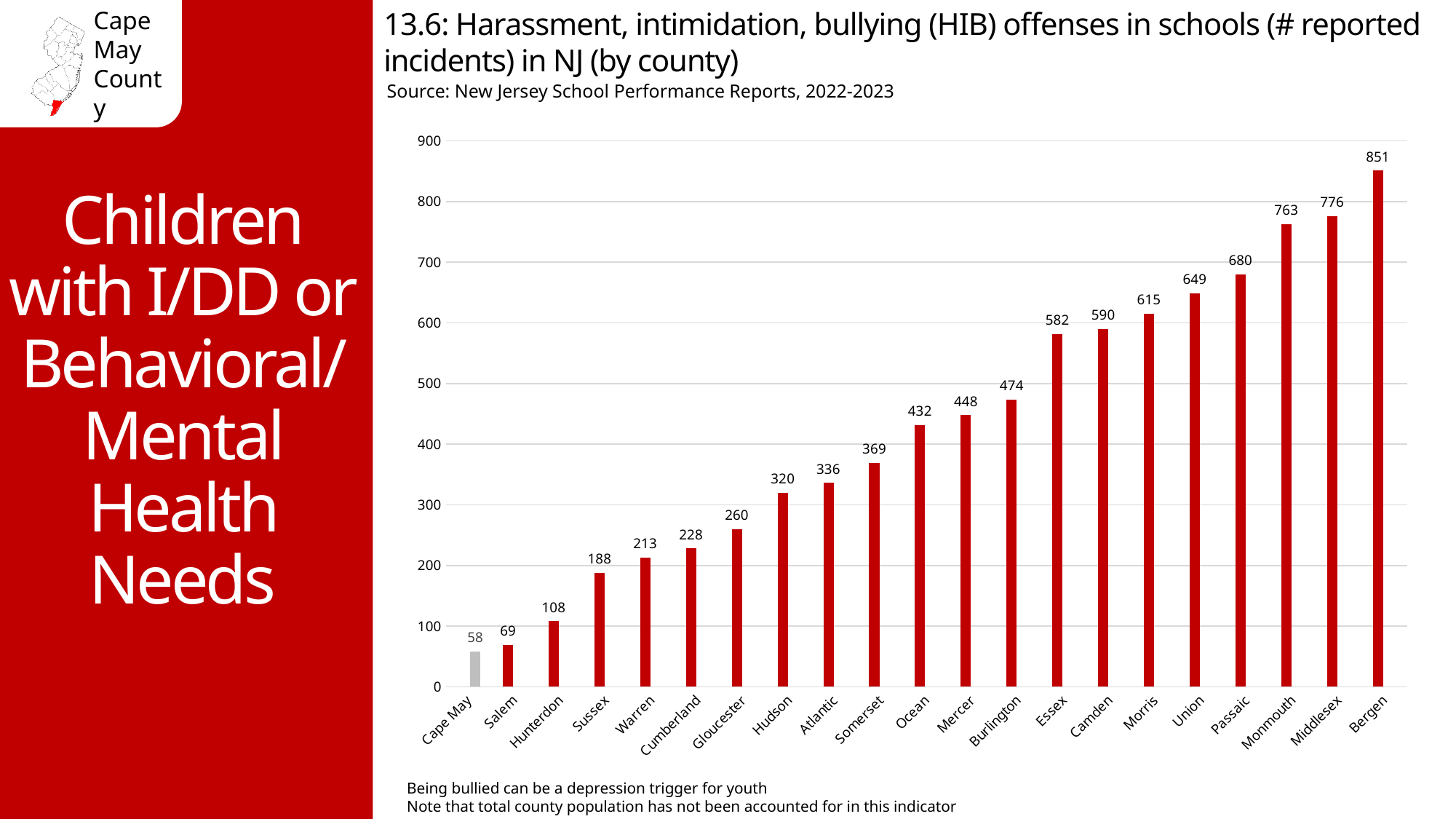
Which county has the highest number of reported HIB incidents? Bergen What is the difference between the values for Essex and Camden? 8 What is the value shown for Hudson? 320 What is the value shown for Monmouth? 763 Which county has the lowest number of reported HIB incidents? Cape May Do the values rise or fall moving from left to right along the x axis? Rise What kind of chart is shown on the slide? Bar chart Which bar is coloured differently (grey) from the others? Cape May How many counties are shown on the x axis? 21 Which has a higher value, Ocean or Burlington? Burlington What is the difference between the values for Bergen and Cape May? 793 How many reported HIB incidents does the chart show for Cape May? 58